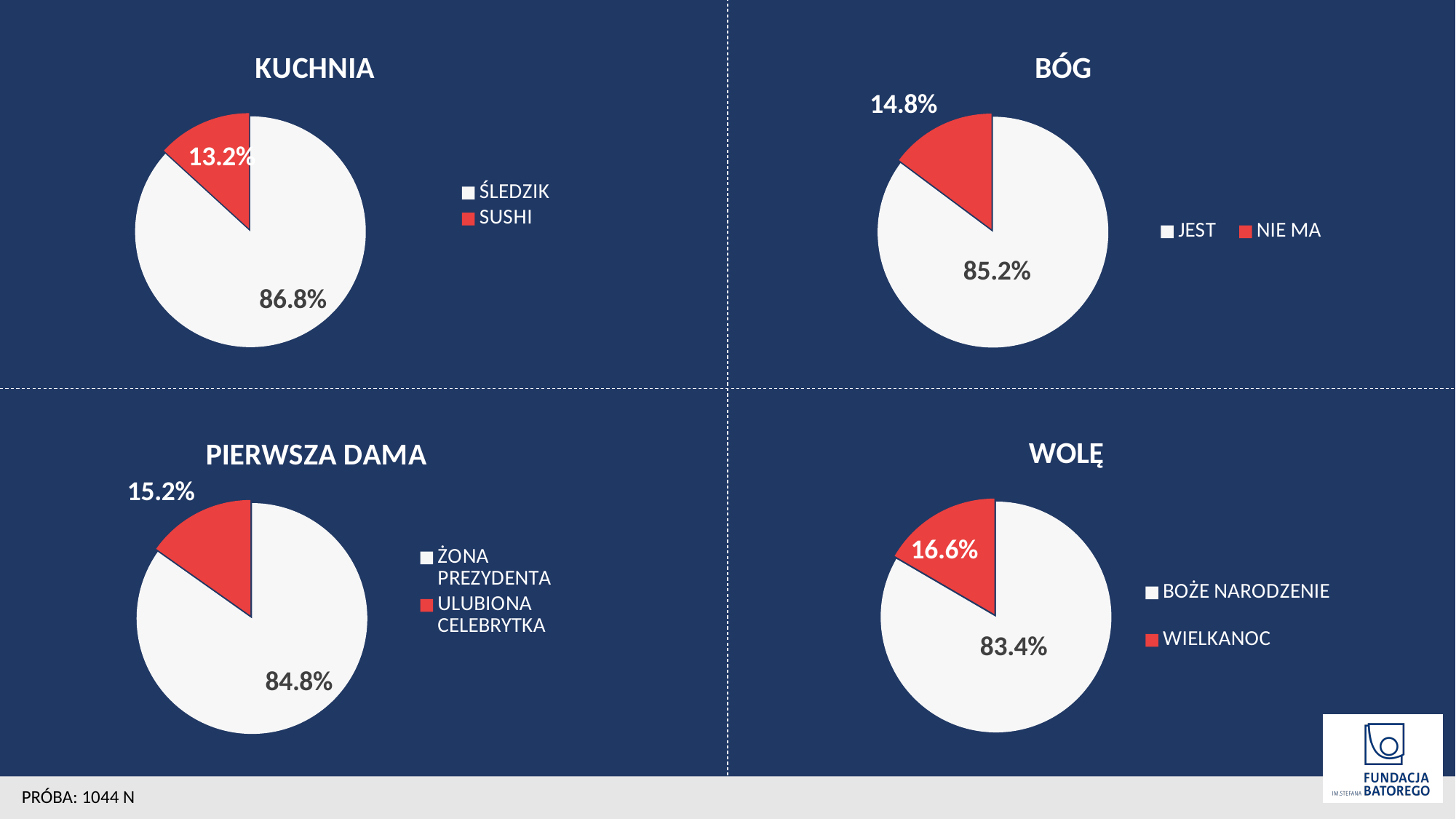
In the KUCHNIA chart, what is the value for SUSHI? 13.2% In the KUCHNIA chart, what share of the pie is ŚLEDZIK? 86.8% In the WOLĘ chart, what is the difference between BOŻE NARODZENIE and WIELKANOC? 66.8% In the PIERWSZA DAMA chart, which category is the largest? ŻONA PREZYDENTA What kind of chart is the BÓG chart? Pie chart In the PIERWSZA DAMA chart, what is the value for ULUBIONA CELEBRYTKA? 15.2% In the KUCHNIA chart, which is smaller, ŚLEDZIK or SUSHI? SUSHI In the BÓG chart, what is the value for NIE MA? 14.8% How many categories does the WOLĘ chart's legend list? 2 In the WOLĘ chart, what is the value for WIELKANOC? 16.6% In the BÓG chart, what is the value for JEST? 85.2% In the BÓG chart, what colour is the NIE MA slice? Red